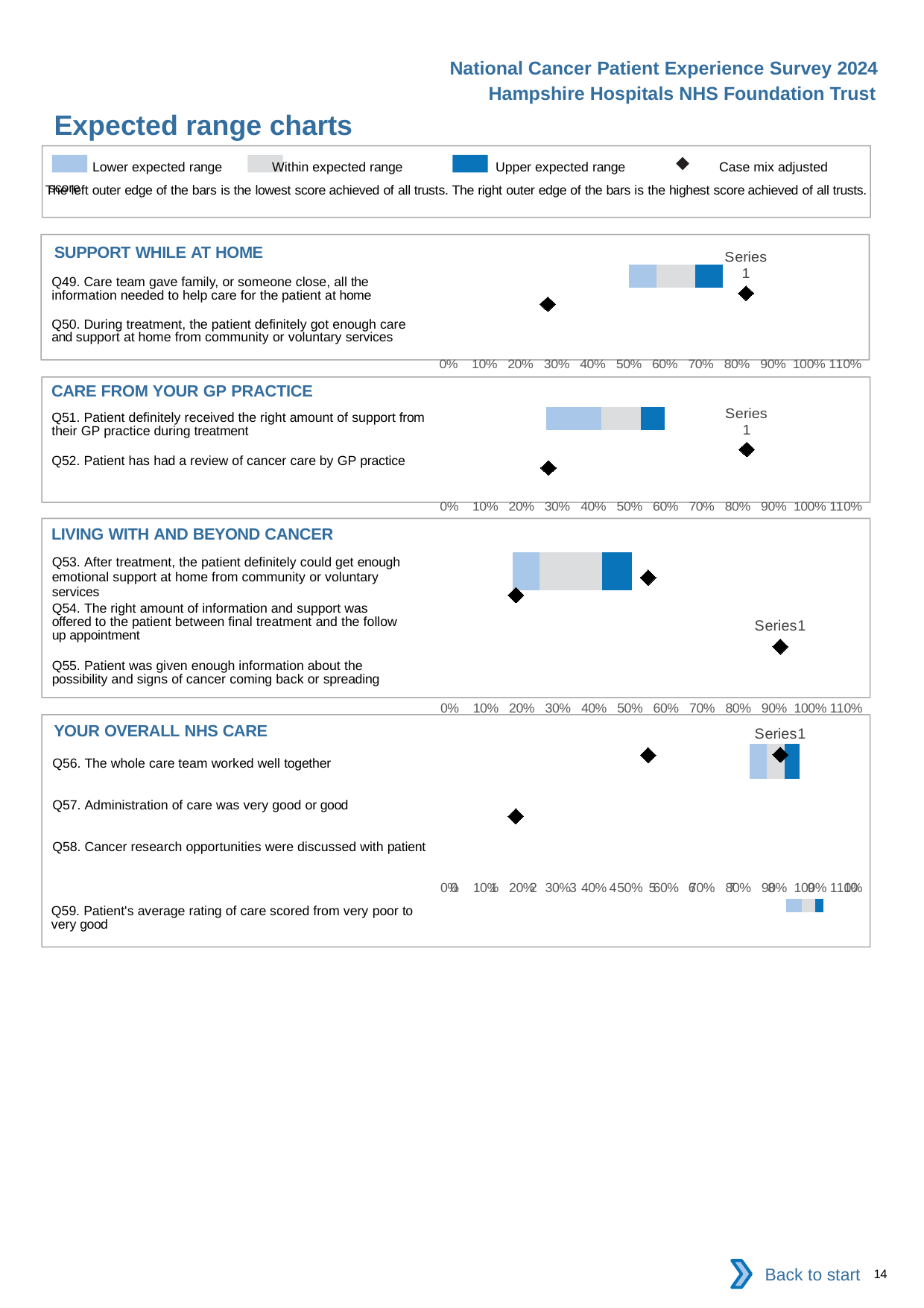
How many entries does the legend at the top of the slide list? 4 What kind of chart is used in the SUPPORT WHILE AT HOME section? bar chart What is the highest value shown on the x axis of the CARE FROM YOUR GP PRACTICE chart? 110% In the LIVING WITH AND BEYOND CANCER chart, is the lowest case mix adjusted score marker greater or less than 30%? less In the SUPPORT WHILE AT HOME chart, is the higher of the two case mix adjusted score markers greater or less than 70%? greater According to the legend, what does the diamond marker represent? Case mix adjusted score In the SUPPORT WHILE AT HOME chart, is the lower of the two case mix adjusted score markers greater or less than 40%? less How many questions are listed in the LIVING WITH AND BEYOND CANCER chart? 3 How many questions are listed in the CARE FROM YOUR GP PRACTICE chart? 2 How many questions are listed in the YOUR OVERALL NHS CARE chart? 4